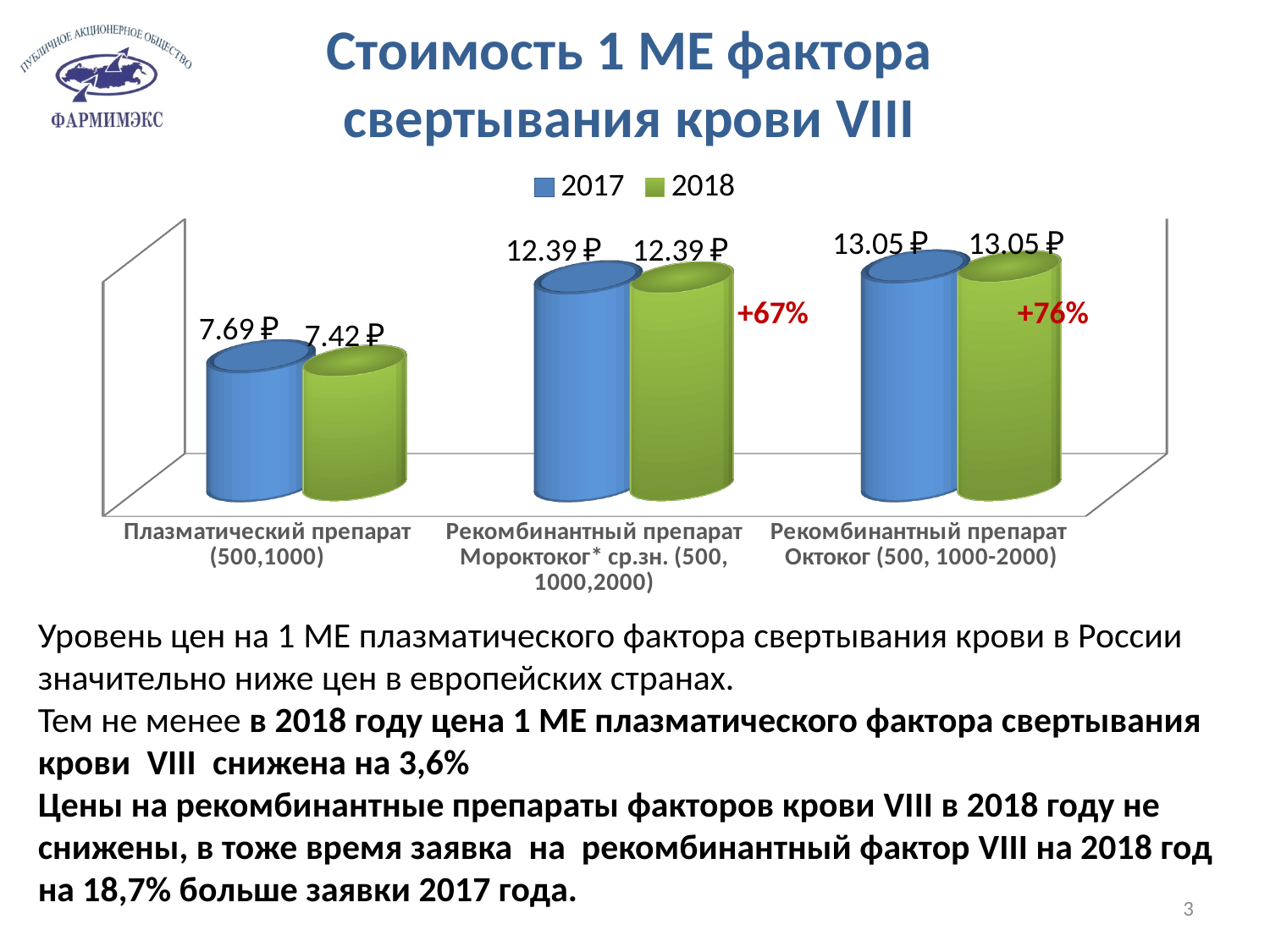
What is the 2018 value for Плазматический препарат (500,1000)? 7.42 ₽ For Плазматический препарат (500,1000), which is larger: the 2017 value or the 2018 value? 2017 How many categories are shown on the x axis? 3 Which category has the lowest 2017 value? Плазматический препарат (500,1000) What is the 2017 value for Плазматический препарат (500,1000)? 7.69 ₽ What is the difference between the 2017 and 2018 values for Плазматический препарат (500,1000)? 0.27 ₽ What kind of chart is shown on the slide? Bar chart What is the 2017 value for Рекомбинантный препарат Октоког (500, 1000-2000)? 13.05 ₽ How many series does the legend list? 2 What is the difference between the 2018 values for Рекомбинантный препарат Октоког (500, 1000-2000) and Рекомбинантный препарат Мороктоког* ср.зн. (500, 1000,2000)? 0.66 ₽ Which category has the highest 2018 value? Рекомбинантный препарат Октоког (500, 1000-2000) What is the 2018 value for Рекомбинантный препарат Мороктоког* ср.зн. (500, 1000,2000)? 12.39 ₽